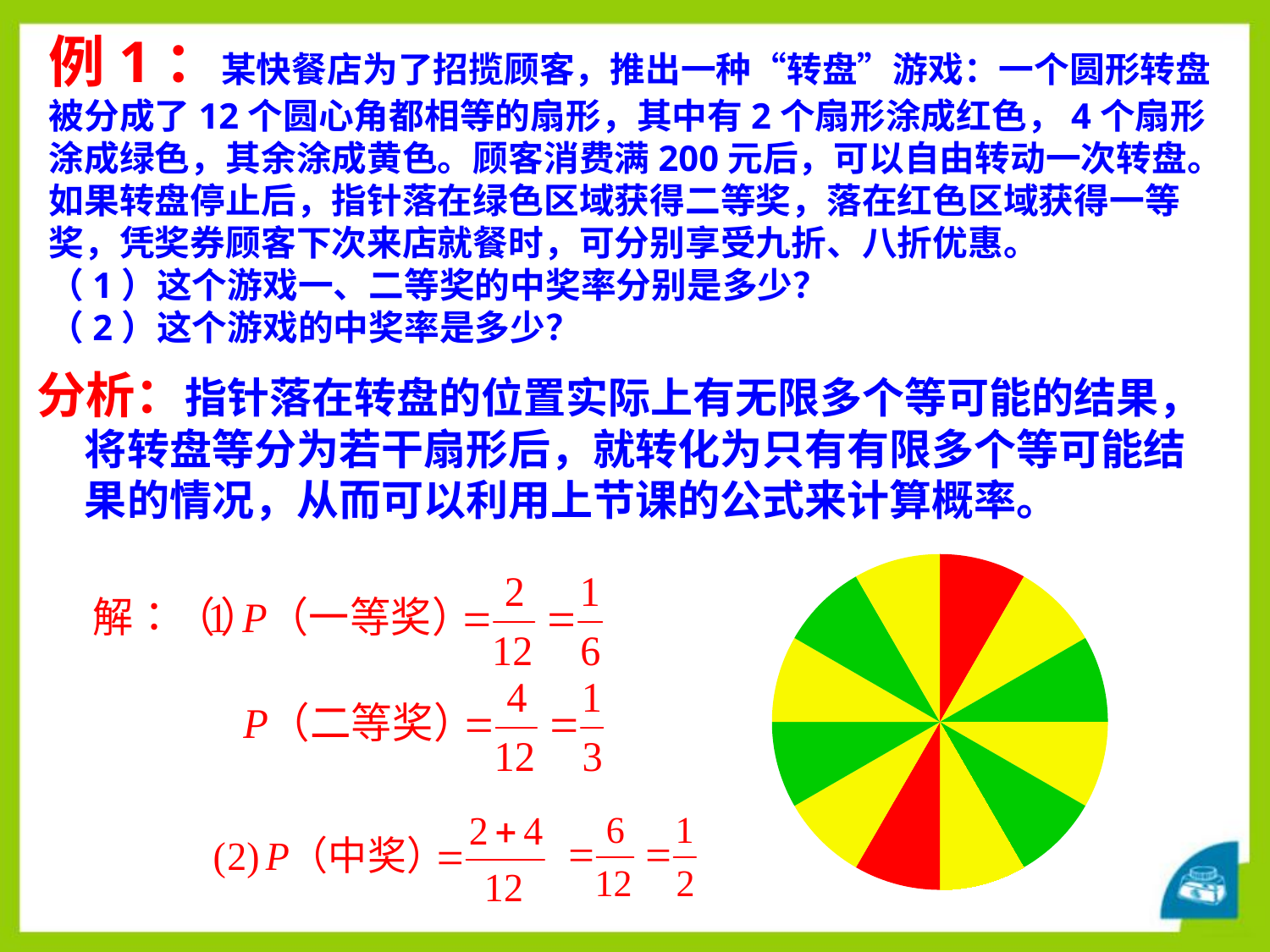
Which colour covers the fewest sectors of the spinner? red How many equal sectors is the spinner on the right divided into? 12 How many sectors of the spinner are coloured red? 2 What kind of chart is the circular diagram on the right of the slide? pie chart How many sectors of the spinner are coloured green? 4 Are there more green sectors or red sectors on the spinner? green Which colour covers the most sectors of the spinner? yellow How many more yellow sectors than red sectors are there on the spinner? 4 What fraction of the spinner is green, as given in the solution for P(二等奖)? 1/3 How many different colours are used on the spinner? 3 How many sectors of the spinner are coloured yellow? 6 What fraction of the spinner is red, as given in the solution for P(一等奖)? 1/6